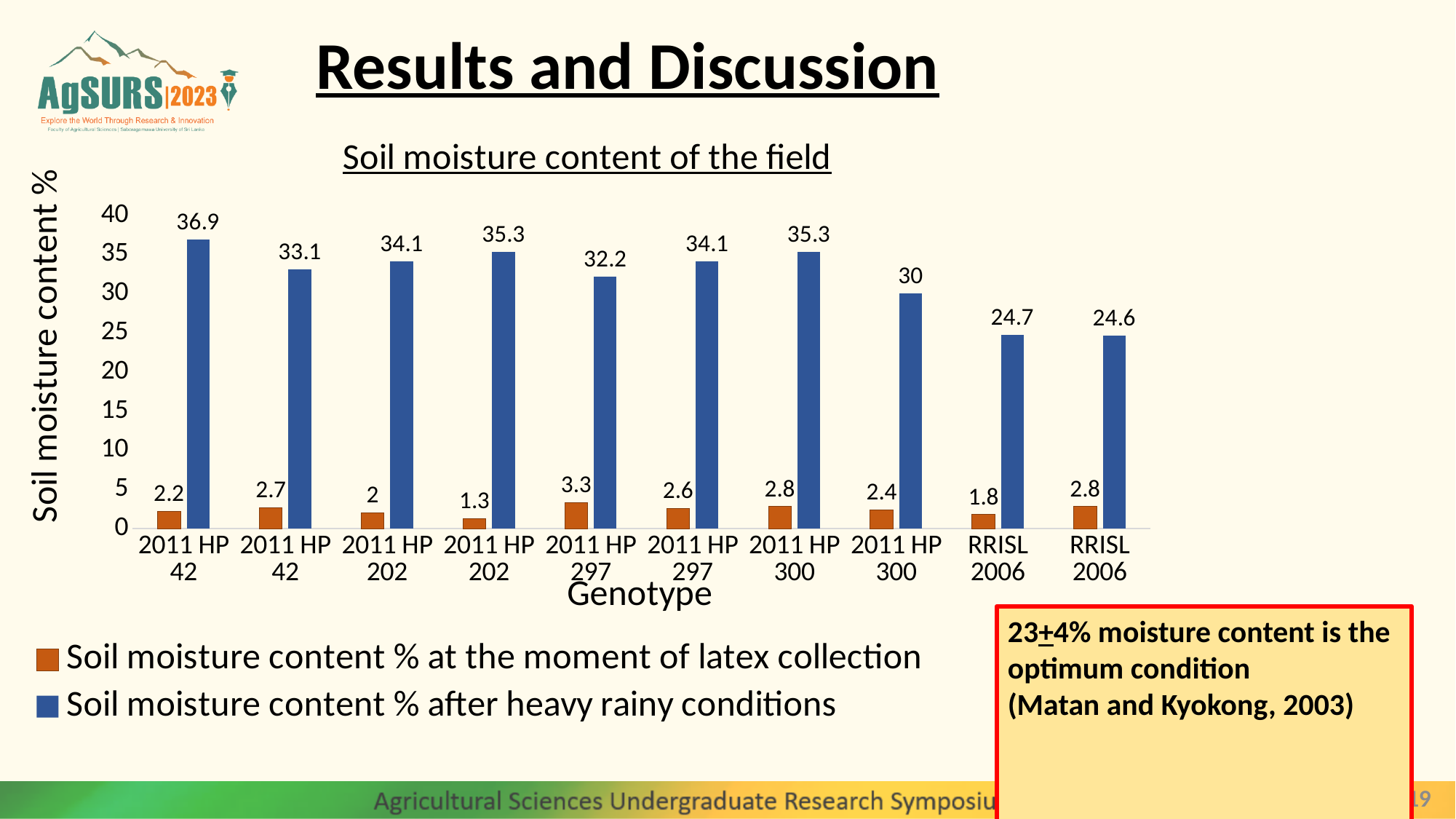
What is the soil moisture content % at the moment of latex collection for the first RRISL 2006 bar? 1.8 What is the highest soil moisture content % after heavy rainy conditions shown on the chart? 36.9 What is the soil moisture content % after heavy rainy conditions for the leftmost 2011 HP 42 bar? 36.9 Is the soil moisture content % after heavy rainy conditions for the first RRISL 2006 bar greater or less than 25? less Which series is shown in blue in the legend? Soil moisture content % after heavy rainy conditions What is the difference between the two soil moisture values for the leftmost 2011 HP 42 genotype (36.9 and 2.2)? 34.7 What type of chart is shown on the slide? bar chart How many series does the legend list? 2 What is the lowest soil moisture content % at the moment of latex collection shown on the chart? 1.3 What is the soil moisture content % after heavy rainy conditions for the second 2011 HP 300 bar (the one labelled 30)? 30 How many genotype categories are plotted along the x axis? 10 Which genotype has the highest soil moisture content % at the moment of latex collection? 2011 HP 297 (first bar, 3.3)